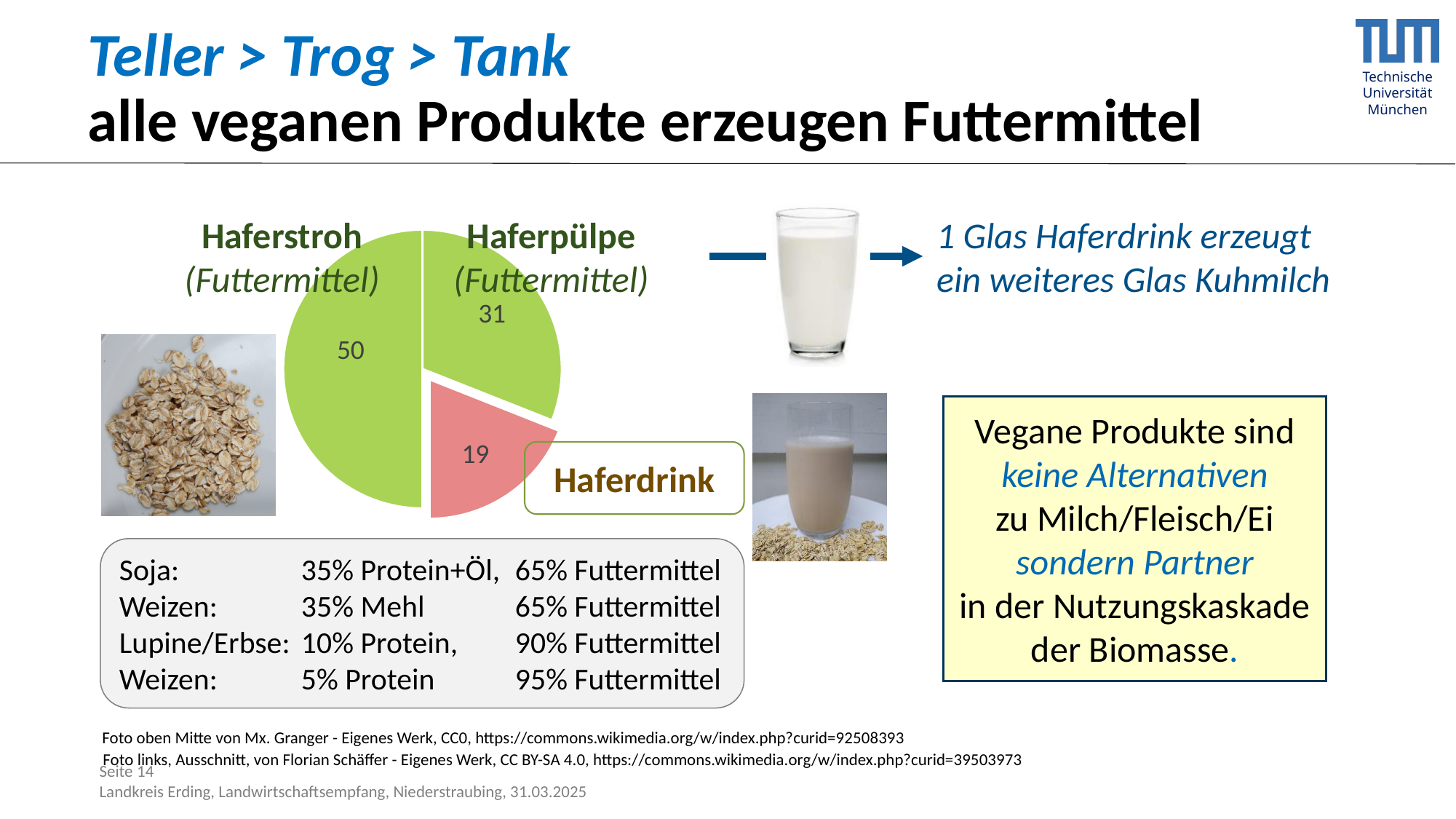
Which is larger in the pie chart, Haferpülpe or Haferdrink? Haferpülpe What is the difference between the Haferpülpe and Haferdrink values in the pie chart? 12 What colour is the Haferdrink slice in the pie chart? red What is the value of the Haferdrink slice in the pie chart? 19 Which slice of the pie chart is the largest? Haferstroh (Futtermittel) What is the difference between the Haferstroh and Haferdrink values in the pie chart? 31 What is the value of the Haferstroh (Futtermittel) slice in the pie chart? 50 Which slice of the pie chart is the smallest? Haferdrink How many slices does the pie chart have? 3 What is the value of the Haferpülpe (Futtermittel) slice in the pie chart? 31 What share of the pie does the Haferdrink slice represent? 19% What kind of chart is shown on the slide? pie chart